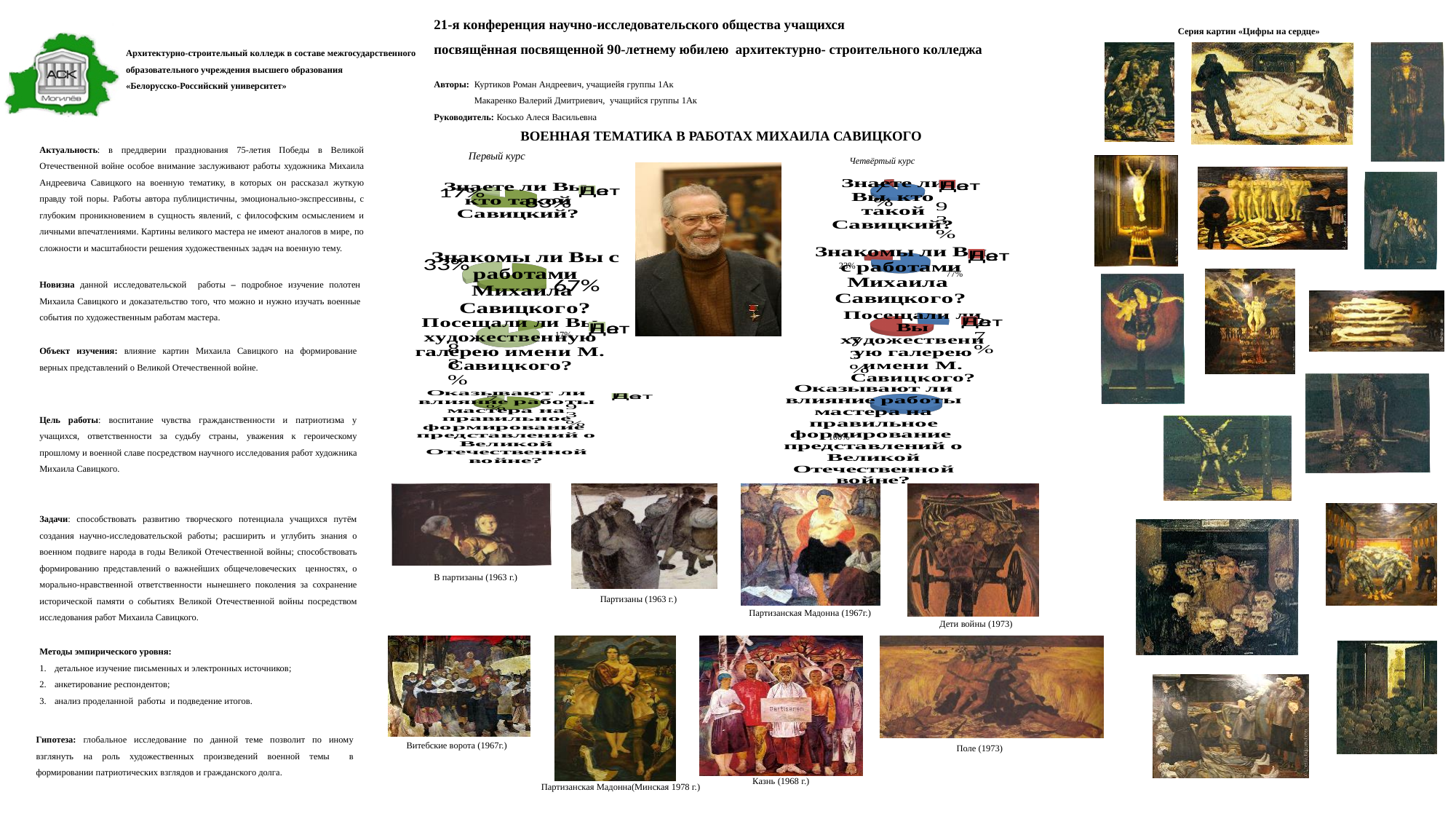
How many entries does the legend of the first-year chart 'Знаете ли Вы, кто такой Савицкий?' list? 2 On the first-year chart 'Знакомы ли Вы с работами Михаила Савицкого?', what is the share of the larger slice? 67% On the fourth-year chart 'Знакомы ли Вы с работами Михаила Савицкого?', what is the share of the smaller slice? 23% On the first-year chart 'Знаете ли Вы, кто такой Савицкий?', what is the share of the larger slice? 83% On the fourth-year chart 'Знакомы ли Вы с работами Михаила Савицкого?', what is the share of the larger slice? 77% What are the two legend entries on the first-year chart 'Знакомы ли Вы с работами Михаила Савицкого?'? Да, Нет What kind of charts are used on the slide to show the survey results for the first-year and fourth-year students? Pie charts Which is larger: the largest slice on the first-year chart 'Знаете ли Вы, кто такой Савицкий?' or the largest slice on the fourth-year chart with the same title? Fourth-year chart On the first-year chart 'Знакомы ли Вы с работами Михаила Савицкого?', what is the difference between the two slices? 34% On the first-year chart 'Знаете ли Вы, кто такой Савицкий?', what is the share of the smaller slice? 17% On the fourth-year chart 'Знаете ли Вы, кто такой Савицкий?', what is the share of the smaller slice? 7% How many slices does the first-year chart 'Посещали ли Вы художественную галерею имени М. Савицкого?' have? 2